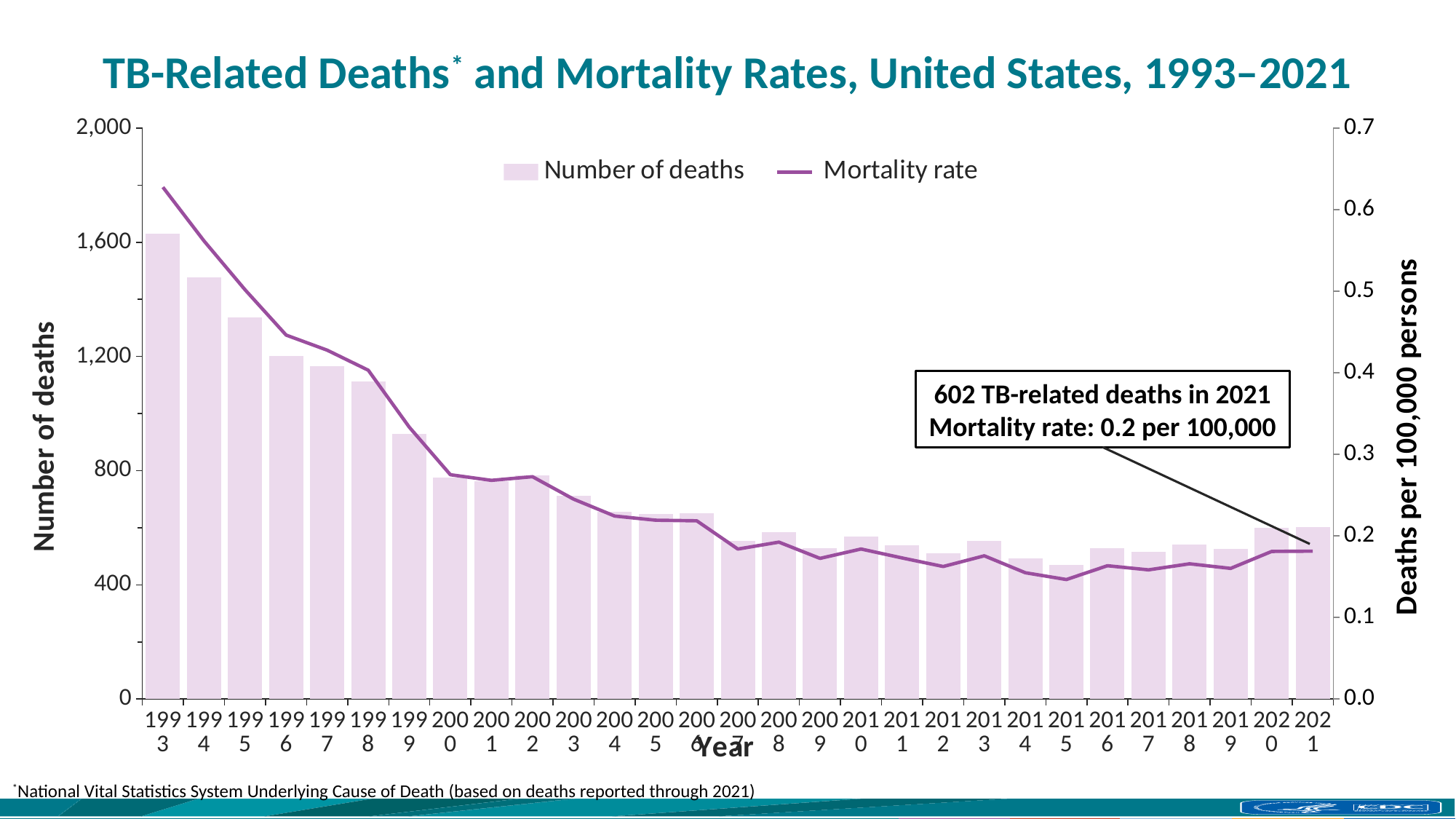
Is the number of deaths in 1993 greater or less than 1,200? greater Is the number of deaths in 2005 greater or less than 800? less What was the TB mortality rate in 2021? 0.2 per 100,000 Which year has the highest mortality rate? 1993 Overall, do the number of deaths rise or fall from 1993 to 2021? Fall Which series is drawn as a line rather than bars? Mortality rate Which year has more deaths, 1993 or 2021? 1993 How many years are shown on the x axis? 29 What kind of chart is shown on the slide? A combined bar and line chart Which year has the highest number of deaths? 1993 How many TB-related deaths were there in 2021? 602 How many series does the legend list? 2